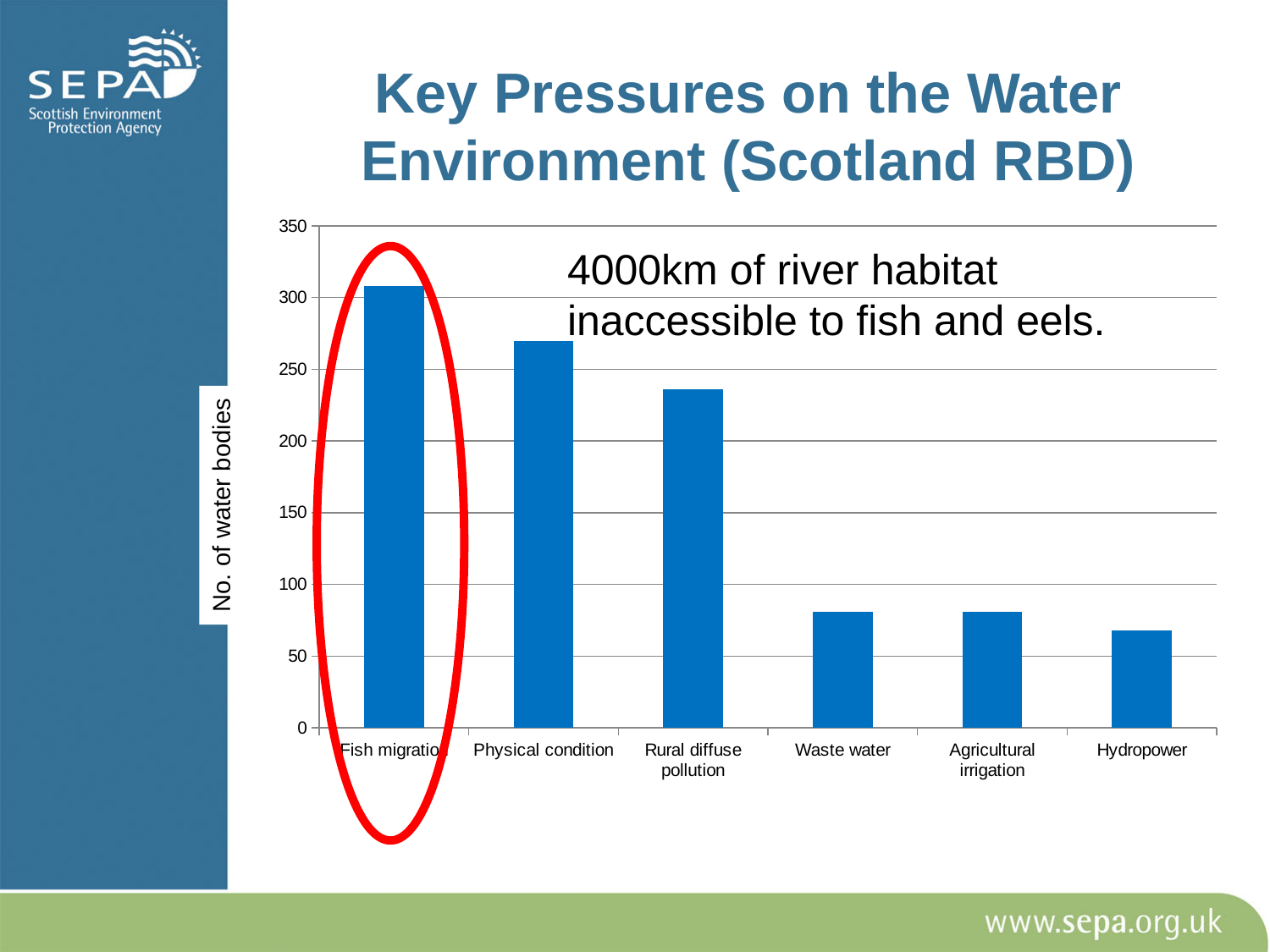
What is the label of the y axis of the chart? No. of water bodies Is the value for Hydropower greater or less than 50? greater Is the value for Rural diffuse pollution greater or less than 250? less Do the values generally rise or fall moving from left to right along the x axis? fall How many categories (pressures) are shown on the x axis of the chart? 6 Which is larger, the value for Physical condition or the value for Rural diffuse pollution? Physical condition What kind of chart is shown on the slide? bar chart Is the value for Fish migration greater or less than 250? greater Which pressure has the lowest number of water bodies? Hydropower Which pressure has the highest number of water bodies? Fish migration